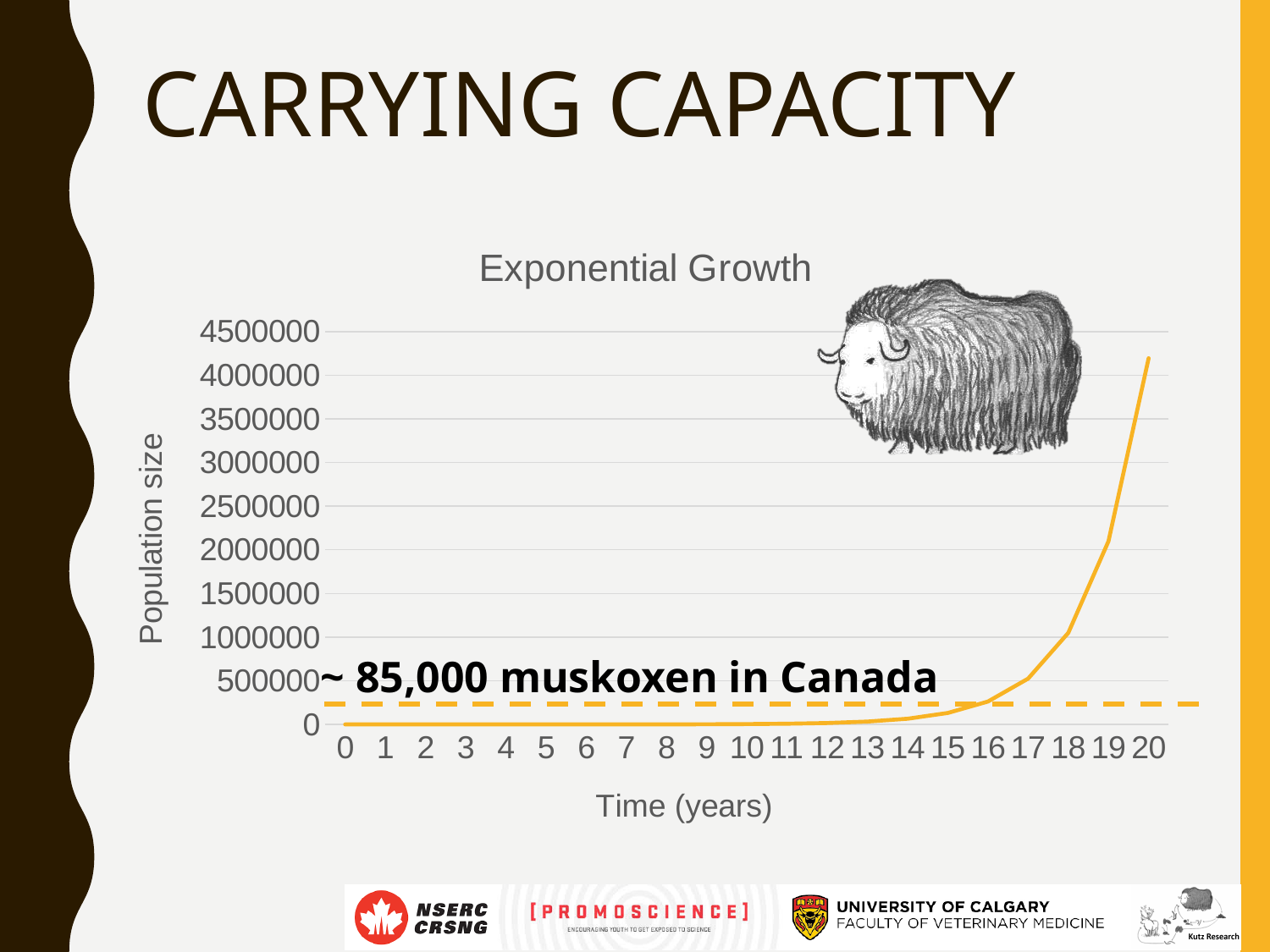
Is the population size at year 10 greater or less than 500000? less Is the population size at year 15 greater or less than 1000000? less How many time points are marked on the x axis? 21 Does the population size rise or fall as time increases along the x axis? rise At which year is the population size highest? 20 What kind of chart is shown on the slide? line chart Which year has the larger population size, year 17 or year 19? 19 What is the title of the chart? Exponential Growth What is the label of the x axis? Time (years) Is the population size at year 20 greater or less than 4000000? greater